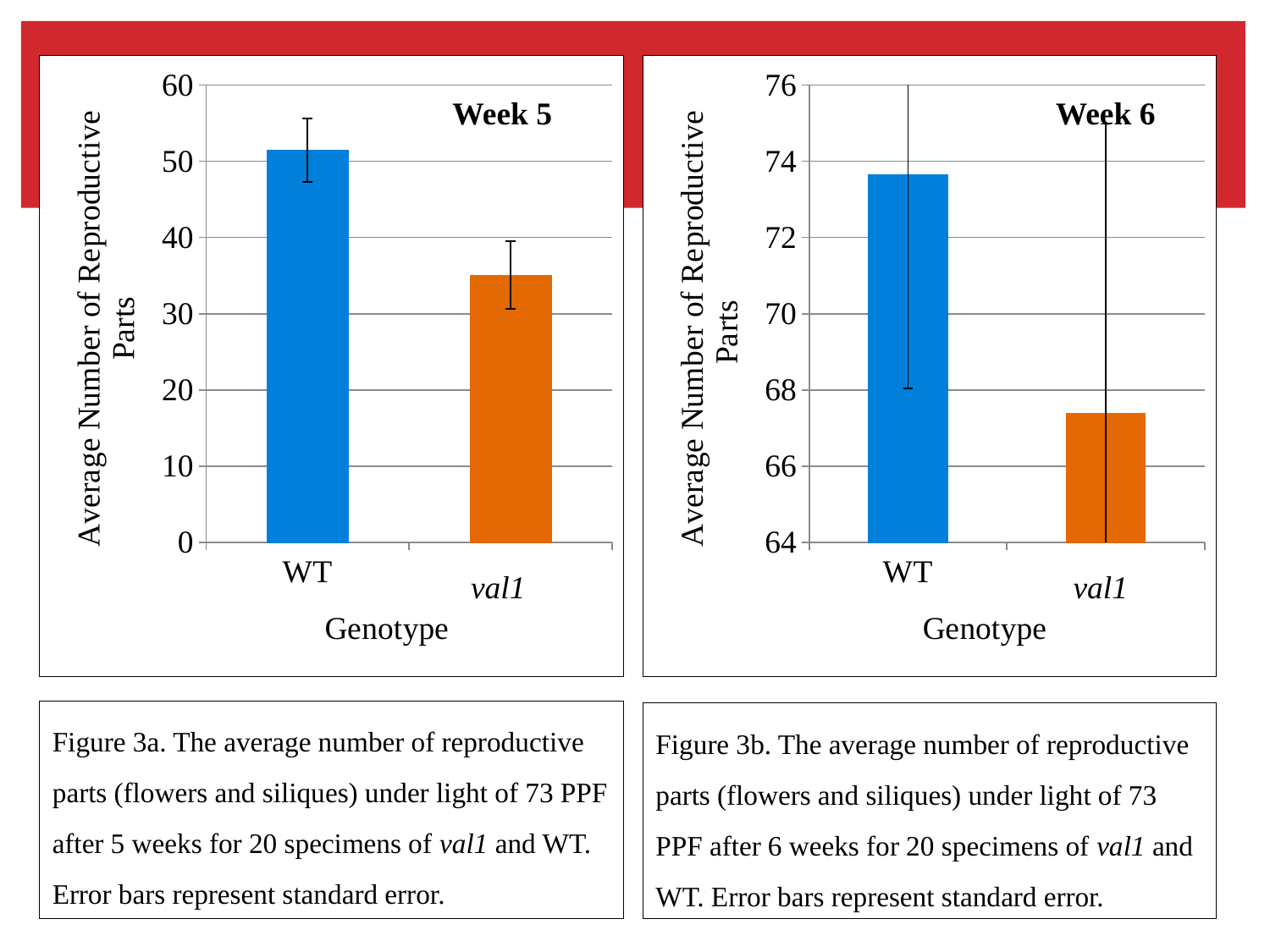
How many genotype categories are shown in the Week 5 chart? 2 In the Week 6 chart, which genotype has the higher average number of reproductive parts? WT What kind of chart is the Week 6 chart? bar chart In the Week 5 chart, which genotype has the higher average number of reproductive parts? WT In the Week 5 chart, is the value for val1 greater or less than 30? greater In the Week 5 chart, is the value for val1 greater or less than 40? less In the Week 6 chart, is the value for val1 greater or less than 68? less In the Week 5 chart, which genotype has the lowest average number of reproductive parts? val1 What is the x-axis label of the Week 5 chart? Genotype